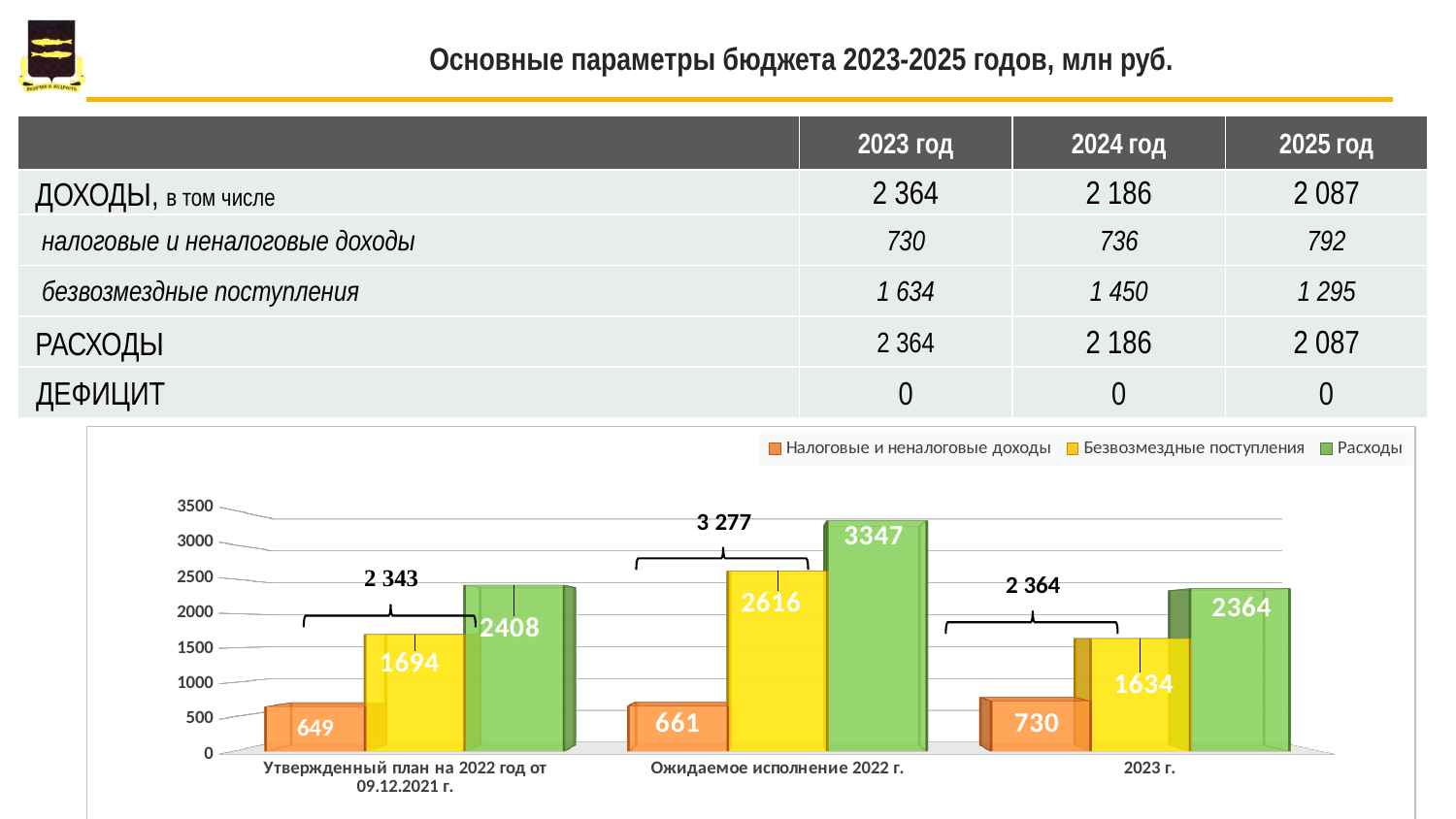
Which category has the lowest value for Налоговые и неналоговые доходы? Утвержденный план на 2022 год от 09.12.2021 г. How many series does the chart legend list? 3 Which colour represents Расходы in the chart? green Which is larger: Безвозмездные поступления for Утвержденный план на 2022 год от 09.12.2021 г. or for 2023 г.? Утвержденный план на 2022 год от 09.12.2021 г. What total is shown above the bracket for Ожидаемое исполнение 2022 г.? 3 277 What is the value of Налоговые и неналоговые доходы for Утвержденный план на 2022 год от 09.12.2021 г.? 649 What is the value of Безвозмездные поступления for 2023 г.? 1634 Which category has the highest value for Расходы? Ожидаемое исполнение 2022 г. What kind of chart is shown on the slide? bar chart What is the value of Расходы for Ожидаемое исполнение 2022 г.? 3347 How many categories are shown on the x axis of the chart? 3 What is the difference between Расходы for Ожидаемое исполнение 2022 г. and Расходы for 2023 г.? 983